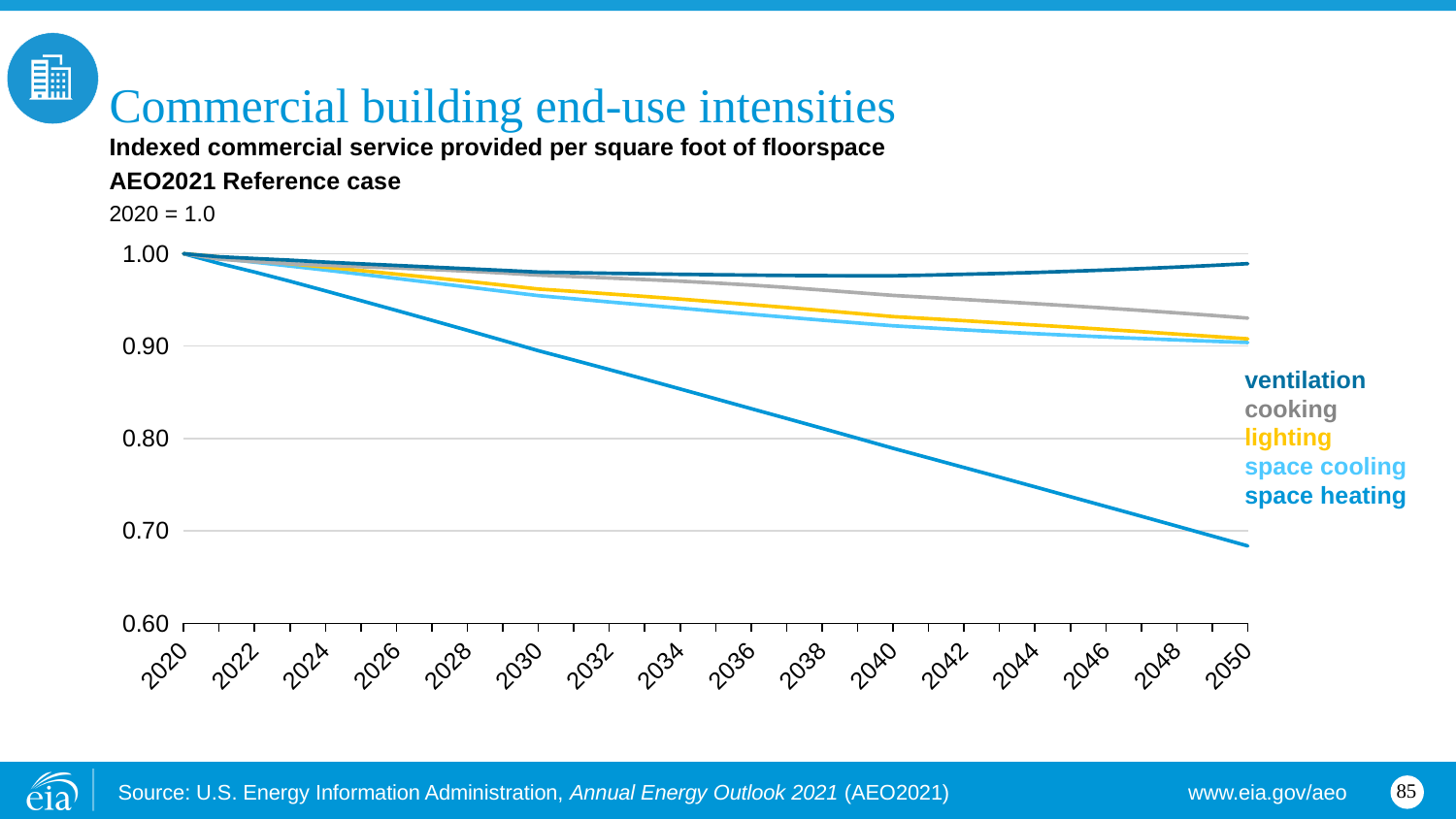
Does the space heating series rise or fall from 2020 to 2050? fall What kind of chart is shown on the slide? line chart How many year labels are shown on the x axis? 16 Which series has the lowest value in 2050? space heating What is the title of the chart? Commercial building end-use intensities Is the value for cooking in 2050 greater or less than 0.90? greater Is the value for space heating in 2050 greater or less than 0.70? less What is the indexed value of every series in 2020? 1.00 Which series has the highest value in 2050? ventilation How many series does the chart's legend list? 5 In 2050, which is larger: the value for cooking or the value for space heating? cooking